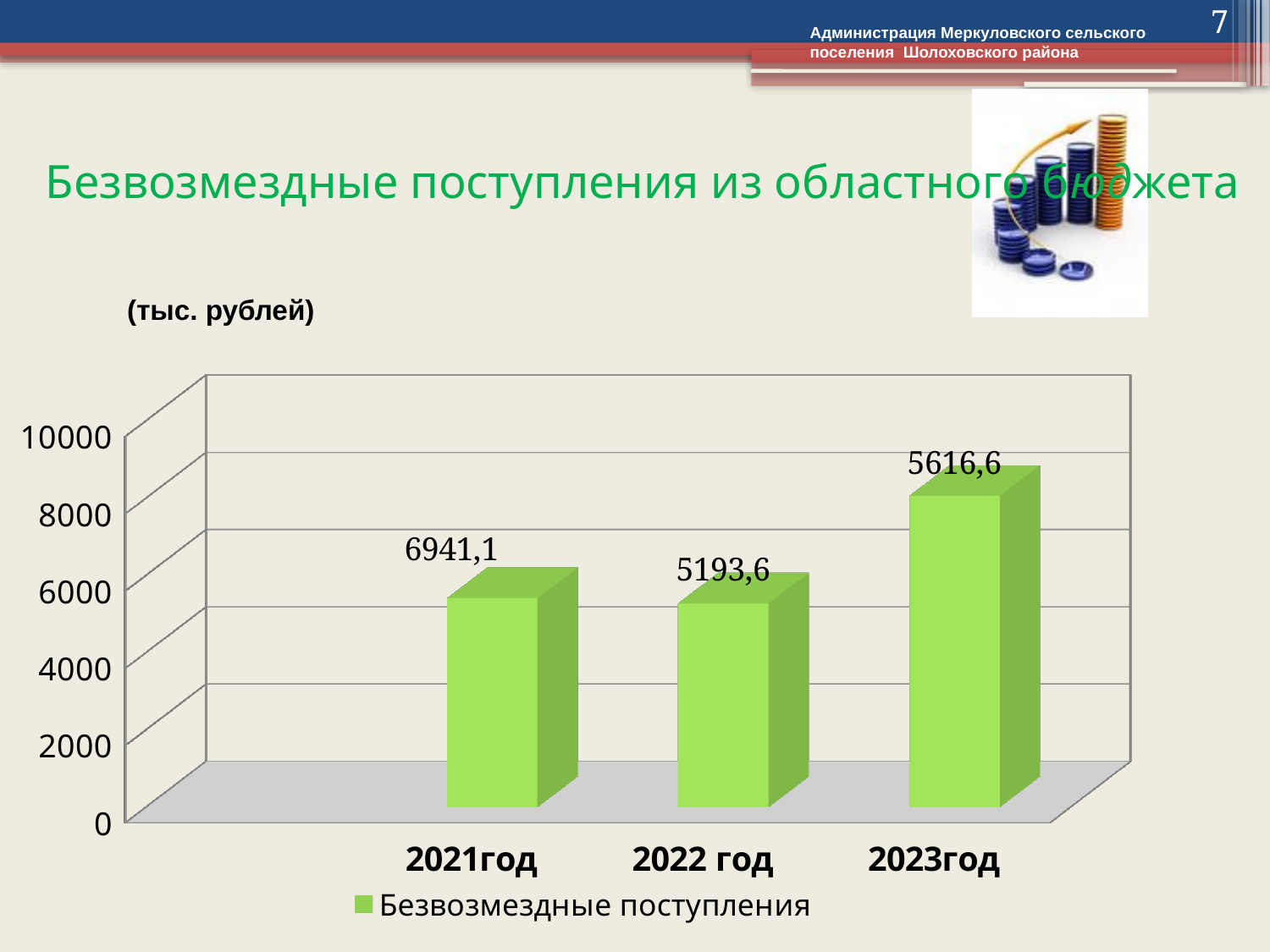
How many categories are shown on the x axis? 3 In what units are the chart values given, according to the label above the chart? тыс. рублей Do the values rise or fall from 2021год to 2022 год? fall How many series does the legend list? 1 What is the legend entry for the series? Безвозмездные поступления What is the difference between the values for 2021год and 2022 год? 1747,5 What kind of chart is shown on the slide? bar chart What is the difference between the values for 2021год and 2023год? 1324,5 What is the difference between the values for 2023год and 2022 год? 423 What is the value for 2022 год? 5193,6 What is the value for 2023год? 5616,6 What is the value for 2021год? 6941,1